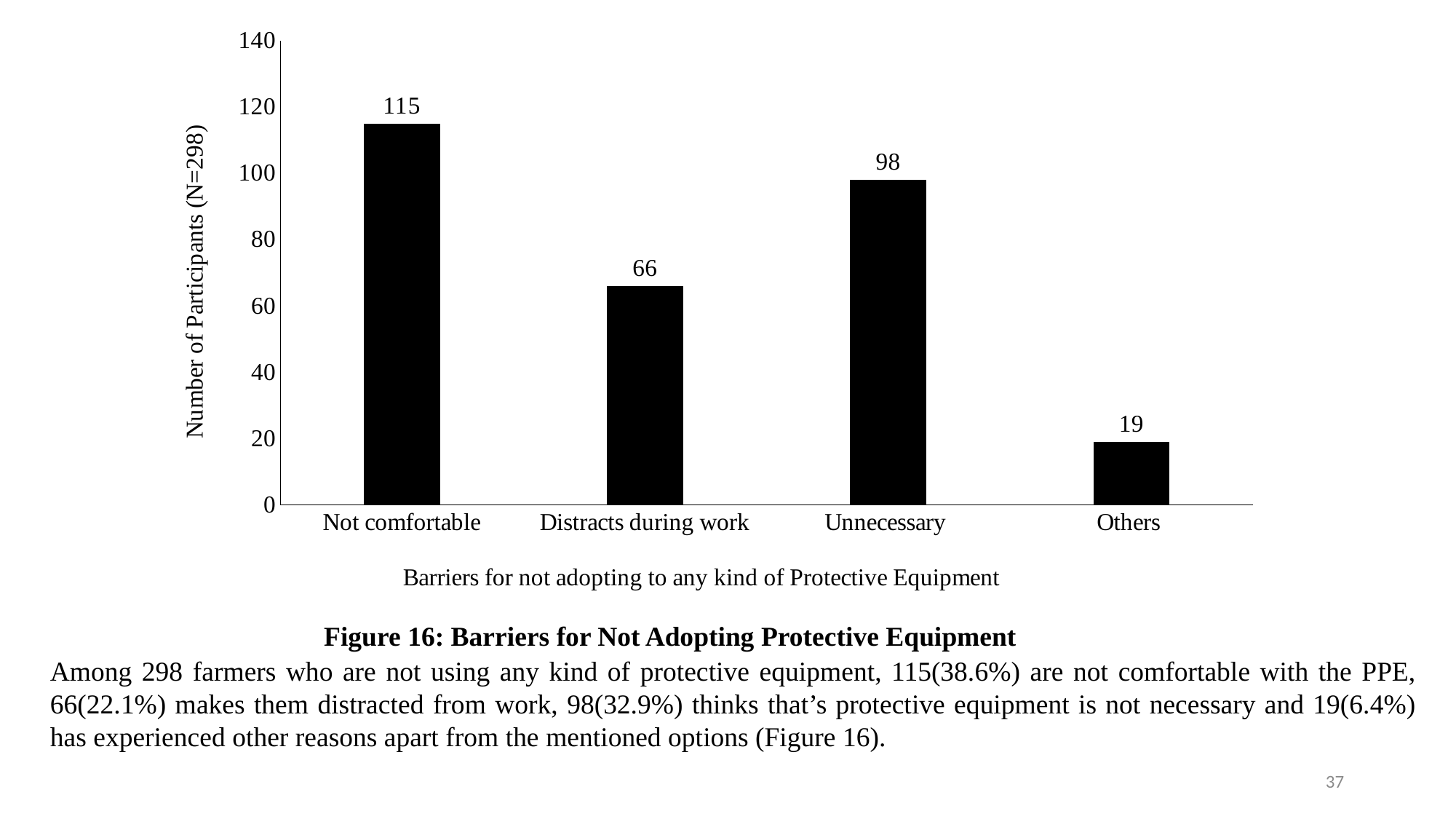
What is the number of participants for 'Distracts during work'? 66 What is the difference between the number of participants for 'Distracts during work' and 'Others'? 47 What is the label of the y-axis of the chart? Number of Participants (N=298) Which has more participants, 'Unnecessary' or 'Distracts during work'? Unnecessary Which barrier has the highest number of participants? Not comfortable What is the number of participants for 'Others'? 19 What is the difference between the number of participants for 'Not comfortable' and 'Unnecessary'? 17 How many barrier categories are shown in the chart? 4 What kind of chart is shown on the slide? Bar chart What is the number of participants for 'Unnecessary'? 98 What is the number of participants for the 'Not comfortable' barrier? 115 Which barrier has the lowest number of participants? Others